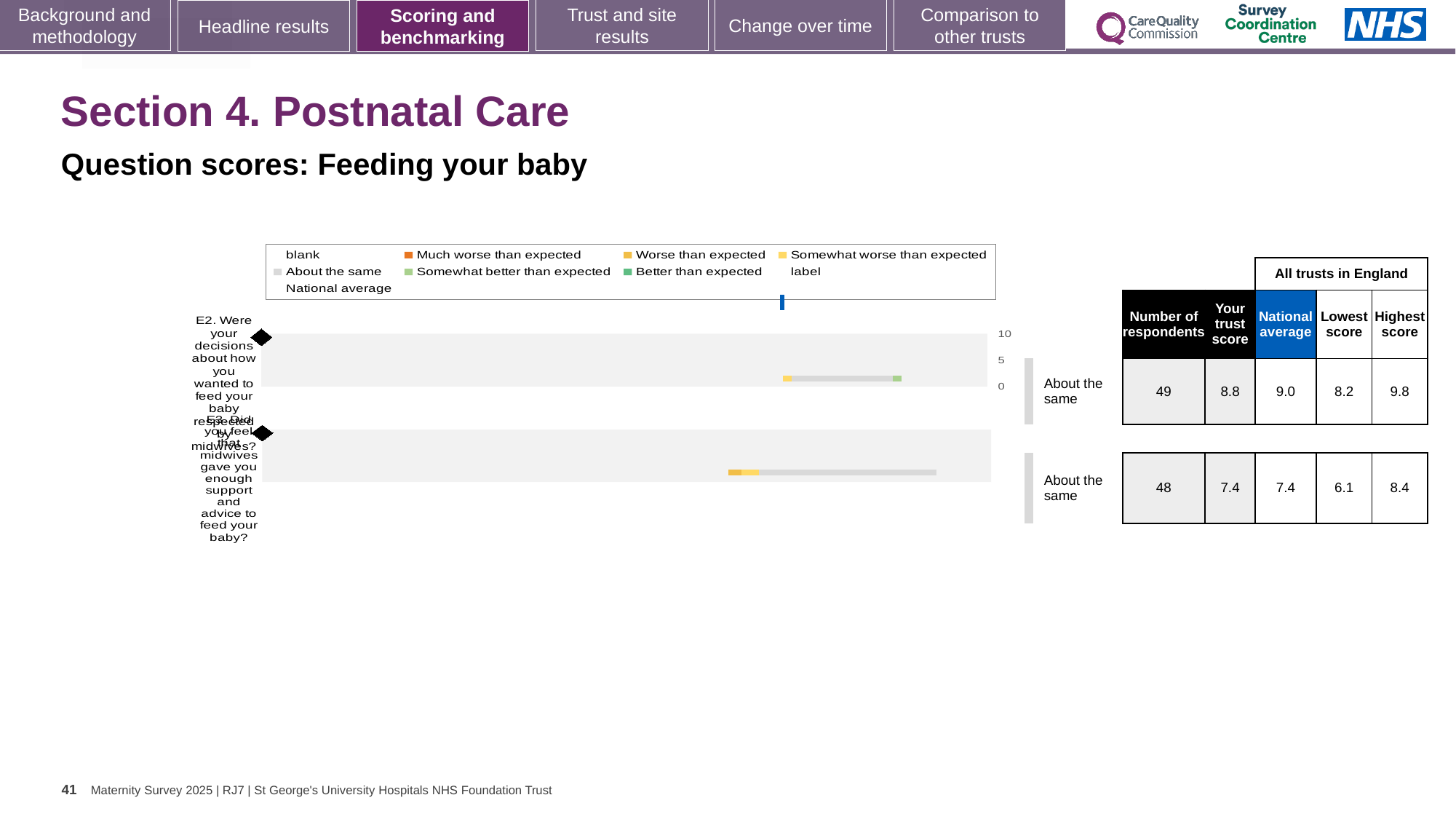
How many survey questions (rows) does the chart show? 2 How many respondents answered question E2? 49 What kind of chart is shown on the slide? Bar chart Which question has the higher trust score, E2 or E3? E2 What benchmark category is shown for question E3? About the same What colour does the legend use for 'Better than expected'? Green What is the national average for question E3 (midwives gave enough support and advice to feed your baby)? 7.4 By how much does the national average exceed the trust score for question E2? 0.2 What is the trust score for question E2 (decisions about how you wanted to feed your baby respected by midwives)? 8.8 What is the lowest score among all trusts in England for question E2? 8.2 What is the highest score among all trusts in England for question E3? 8.4 What is the difference between the highest and lowest scores for question E2? 1.6